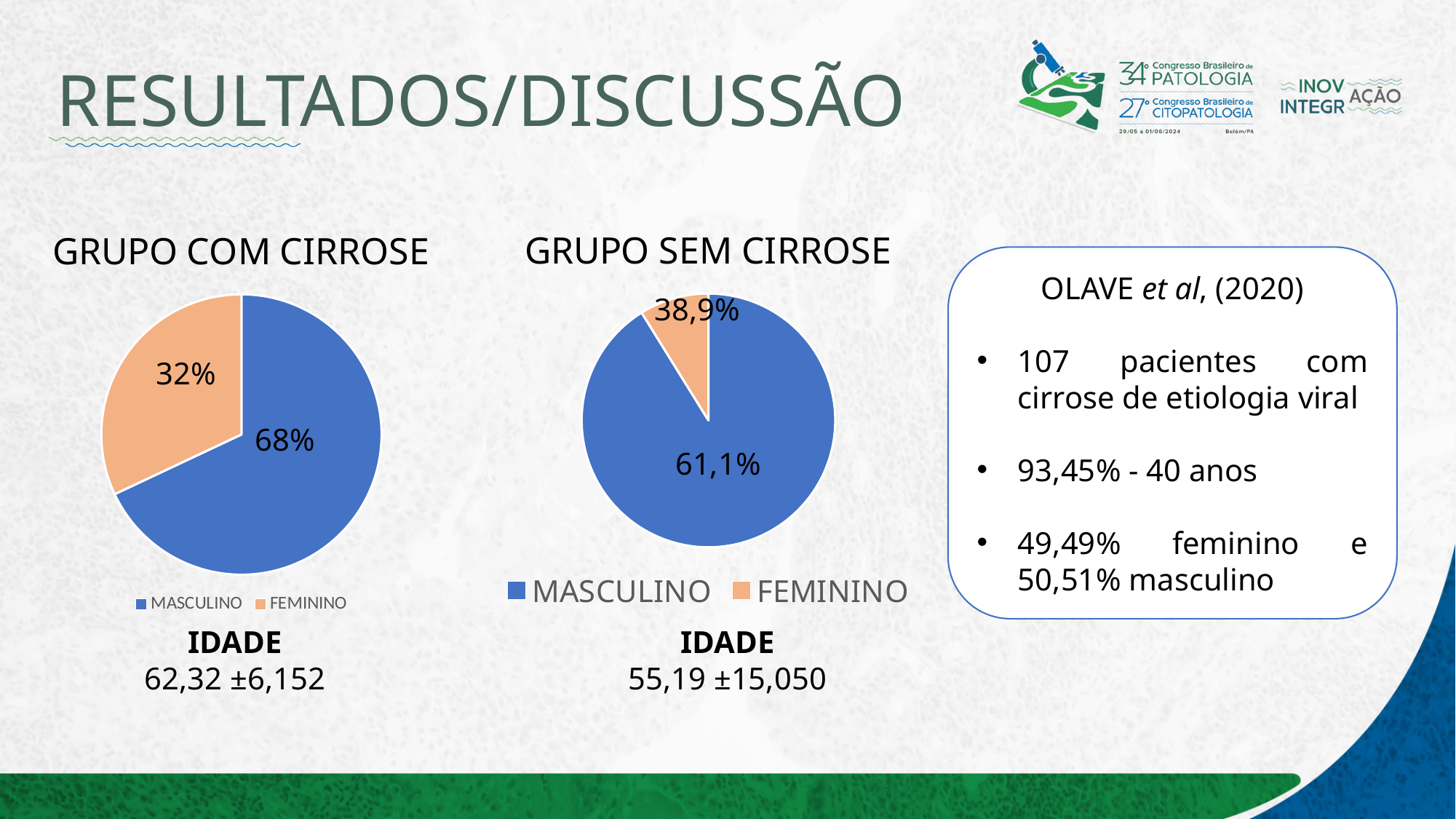
In the GRUPO COM CIRROSE chart, what percentage is shown for MASCULINO? 68% Which is larger: the MASCULINO share in the GRUPO COM CIRROSE chart or the MASCULINO share in the GRUPO SEM CIRROSE chart? GRUPO COM CIRROSE In the GRUPO COM CIRROSE chart, which category has the largest slice? MASCULINO In the GRUPO SEM CIRROSE chart, what percentage is shown for MASCULINO? 61,1% How many categories does the GRUPO COM CIRROSE chart show? 2 In the GRUPO COM CIRROSE chart, what percentage is shown for FEMININO? 32% In the GRUPO SEM CIRROSE chart, what percentage is shown for FEMININO? 38,9% In the GRUPO COM CIRROSE chart, what colour represents FEMININO? Orange In the GRUPO COM CIRROSE chart, what is the difference between the MASCULINO and FEMININO percentages? 36% How many entries does the legend of the GRUPO SEM CIRROSE chart list? 2 What type of chart is used for GRUPO SEM CIRROSE? Pie chart In the GRUPO SEM CIRROSE chart, which category has the smallest slice? FEMININO